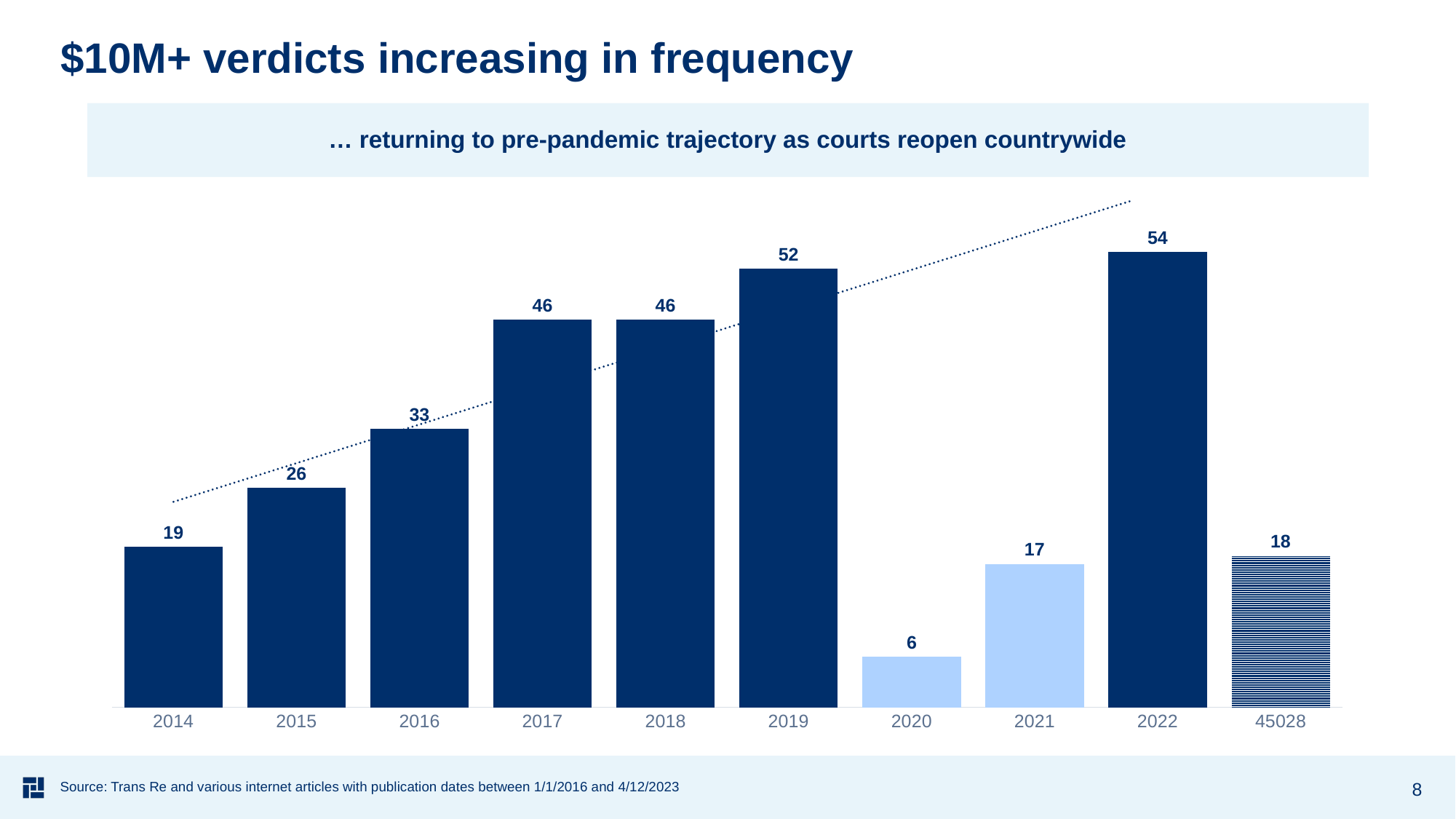
What is the title of the slide containing the chart? $10M+ verdicts increasing in frequency What is the difference between the values for 2022 and 2021? 37 Which is larger, the value for 2015 or the value for 2021? 2015 What is the value for 2019? 52 How many bars are shown in the chart? 10 What kind of chart is shown on the slide? Bar chart What is the value for 2020? 6 Which year has the lowest value? 2020 Which year has the highest value? 2022 What is the difference between the values for 2016 and 2014? 14 Do the values rise or fall from 2014 to 2019? Rise What is the value for the category labelled 45028? 18